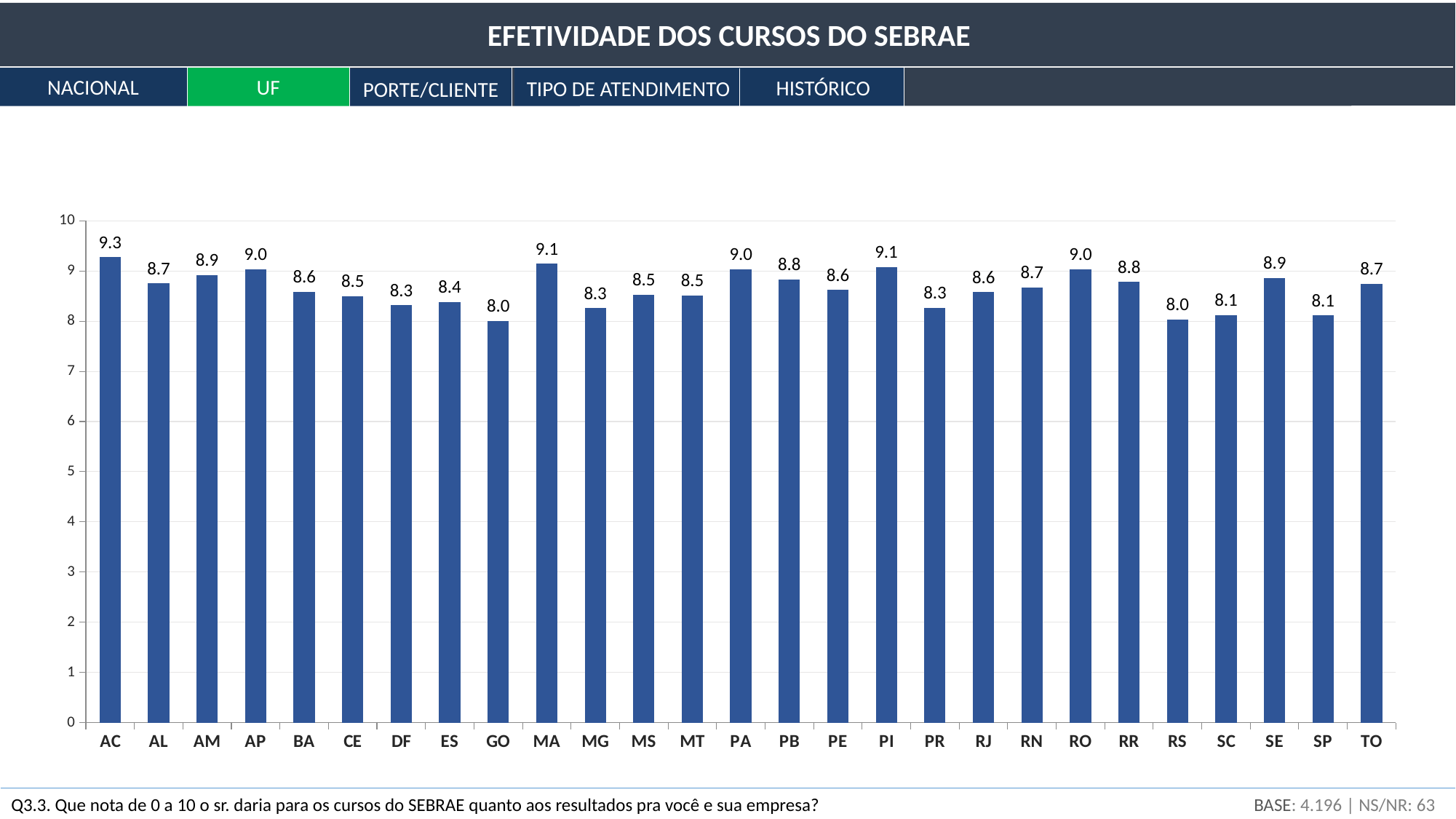
Is the value for RS greater or less than 9? less What is the value for SP? 8.1 What is the difference between the values for AC and GO? 1.3 Which state has the highest value? AC What is the lowest value shown on the chart? 8.0 What kind of chart is shown on the slide? bar chart What is the title of the slide? EFETIVIDADE DOS CURSOS DO SEBRAE What is the value for PI? 9.1 How many states are shown on the x axis? 27 What is the value for AC? 9.3 What is the value for PB? 8.8 Which is larger, the value for MA or the value for MG? MA